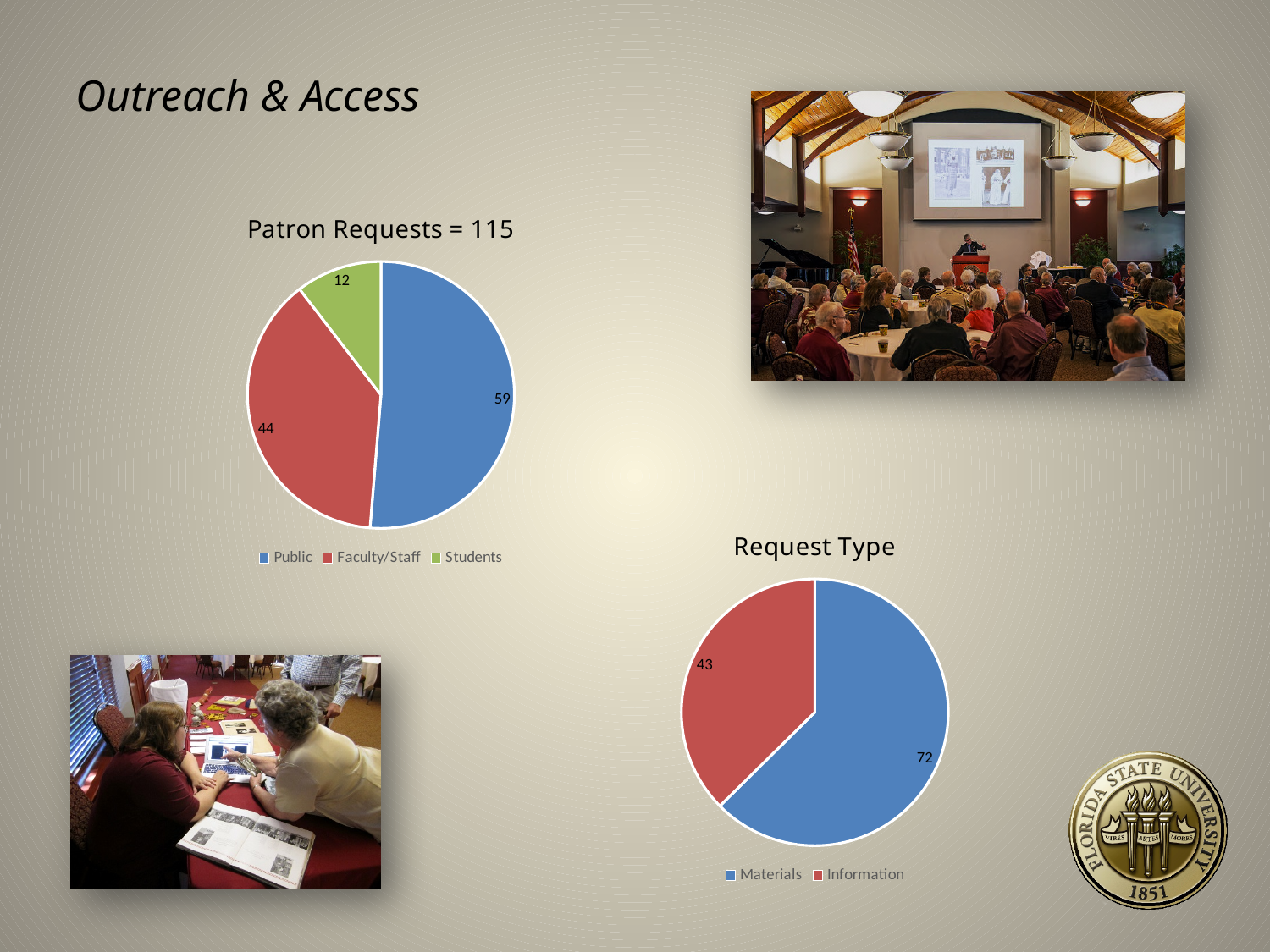
In the Patron Requests = 115 chart, what is the value for Public? 59 In the Request Type chart, which is larger, Materials or Information? Materials In the Patron Requests = 115 chart, which category has the smallest slice? Students In the Patron Requests = 115 chart, what is the difference between the Public and Faculty/Staff values? 15 In the Patron Requests = 115 chart, what is the value for Faculty/Staff? 44 In the Request Type chart, what is the difference between the Materials and Information values? 29 In the Patron Requests = 115 chart, which category has the largest slice? Public In the Patron Requests = 115 chart, how many categories are shown? 3 What type of chart is the Request Type chart? Pie chart In the Request Type chart, what is the value for Information? 43 In the Request Type chart, what is the value for Materials? 72 In the Patron Requests = 115 chart, what is the value for Students? 12